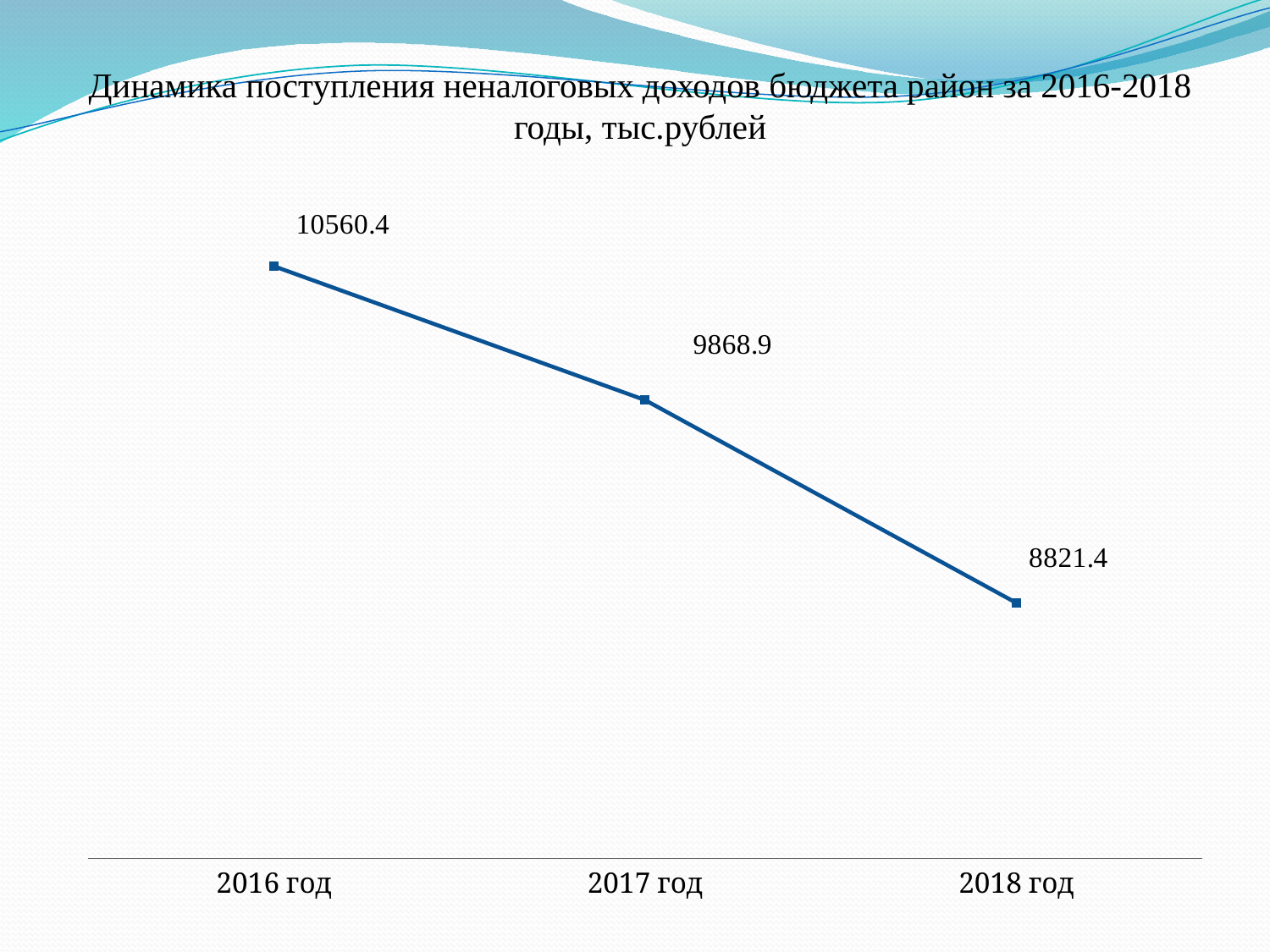
Do the values rise or fall from 2016 год to 2018 год? fall What is the value for 2016 год? 10560.4 Which year has the lowest value? 2018 год Which is larger, the value for 2017 год or the value for 2018 год? 2017 год What is the difference between the values for 2016 год and 2018 год? 1739.0 What is the value for 2017 год? 9868.9 What is the value for 2018 год? 8821.4 Which year has the highest value? 2016 год How many data points are plotted on the chart? 3 What kind of chart is shown on the slide? line chart What is the difference between the values for 2016 год and 2017 год? 691.5 What is the difference between the values for 2017 год and 2018 год? 1047.5